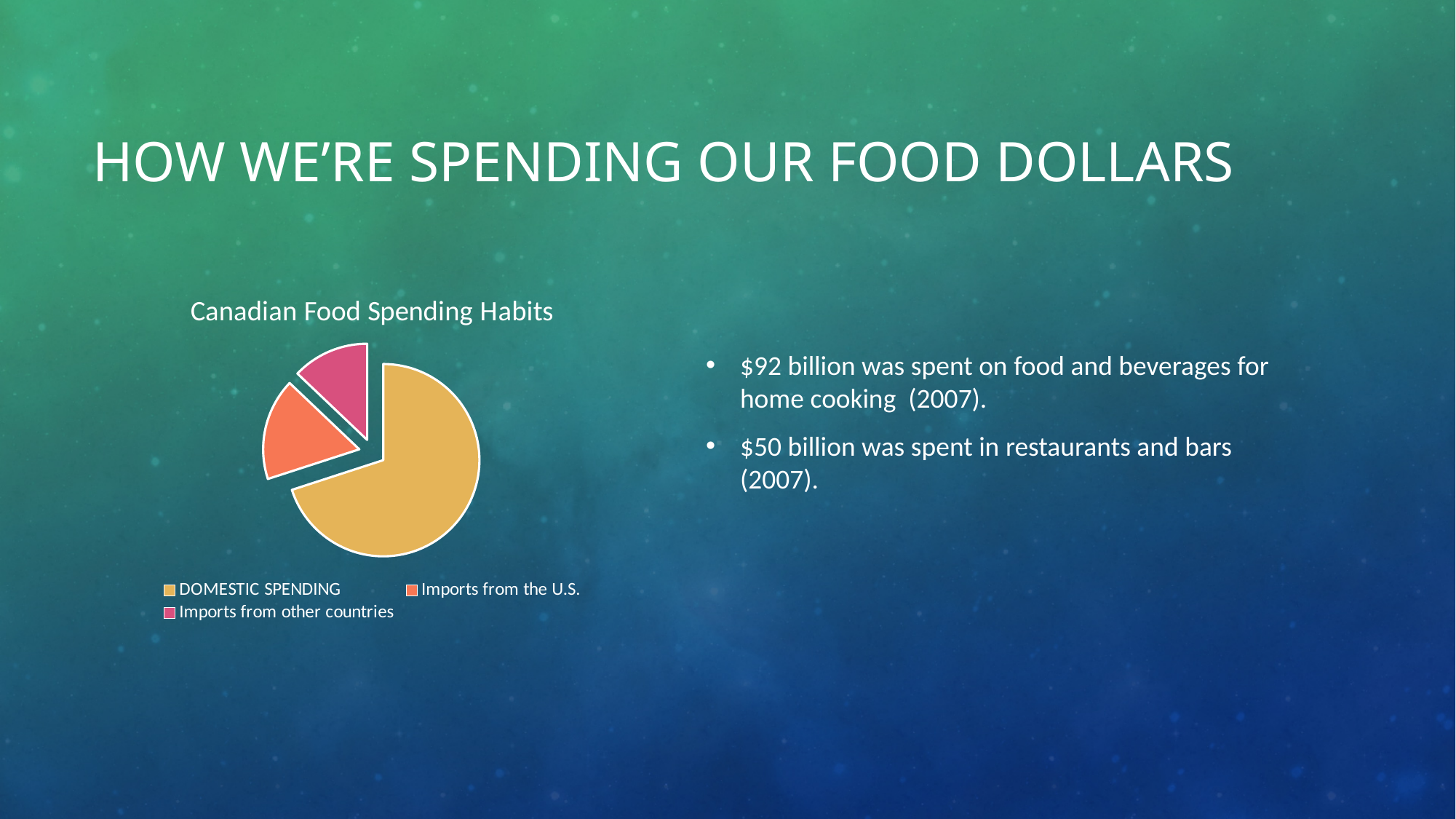
Which is larger: the slice for DOMESTIC SPENDING or the slice for Imports from the U.S.? DOMESTIC SPENDING What colour is the slice for Imports from other countries? Pink How many slices does the pie chart have? 3 What is the title of the chart? Canadian Food Spending Habits How many entries does the chart legend list? 3 What kind of chart is shown on the slide? Pie chart Which category has the largest slice of the pie? DOMESTIC SPENDING Does the DOMESTIC SPENDING slice take up more or less than half of the pie? More Which category has the smallest slice of the pie? Imports from other countries Which is larger: the slice for Imports from the U.S. or the slice for Imports from other countries? Imports from the U.S.